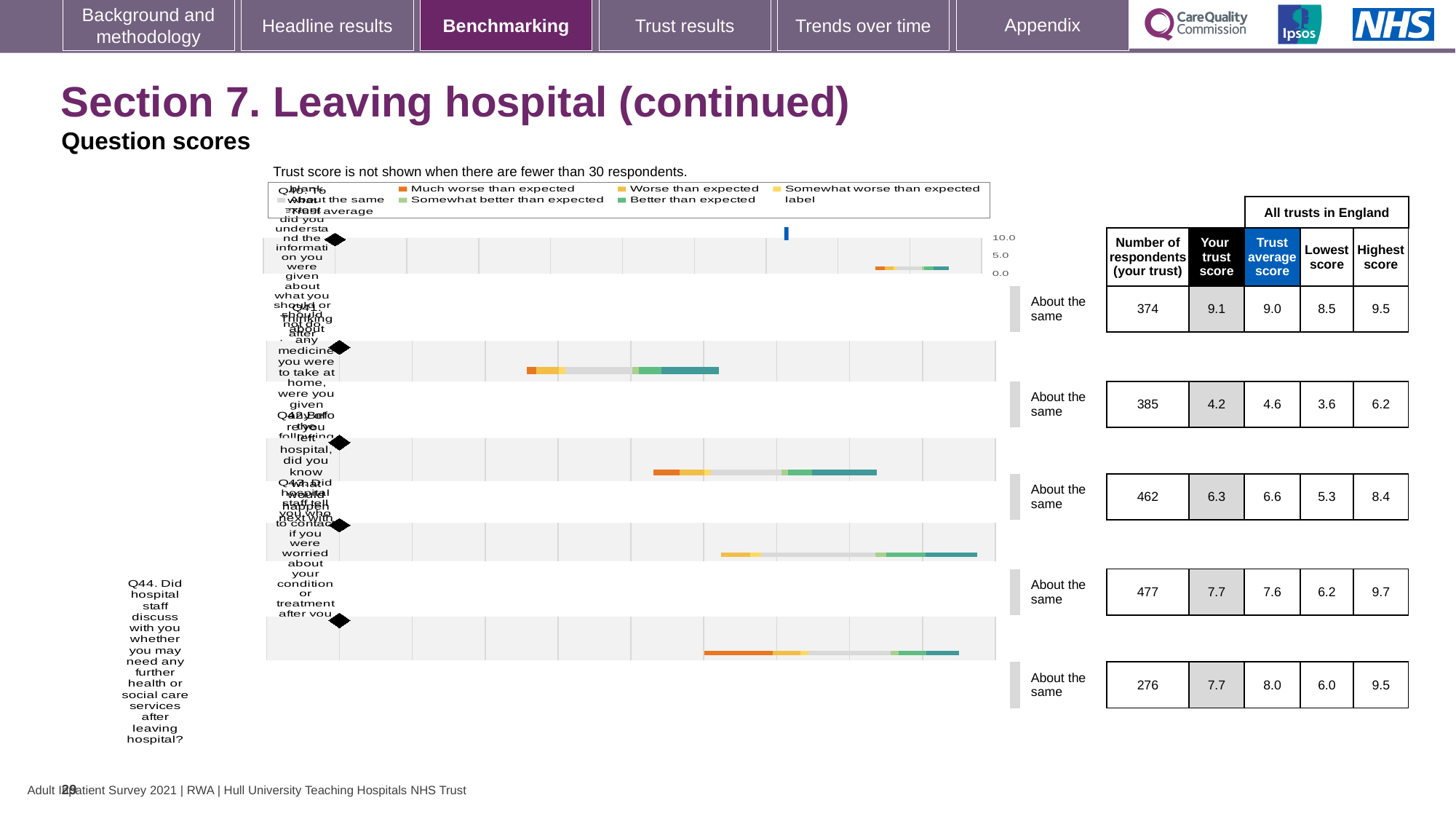
What is the number of respondents (your trust) for Q44 about discussing further health or social care services after leaving hospital? 276 What comparison label is shown next to the Q44 row? About the same What is the highest score among all trusts in England for Q44? 9.5 What is the lowest score among all trusts in England in the top row of the table? 8.5 For Q44, is your trust score higher or lower than the trust average score? lower What is the difference between the highest score and the lowest score for Q44? 3.5 What is your trust score in the top row of the table? 9.1 What kind of chart is used to show the question scores on this slide? bar chart What is your trust score for Q44? 7.7 What is the largest number of respondents shown in the table? 477 How many question rows are shown in the benchmarking chart? 5 What is the trust average score for Q44? 8.0